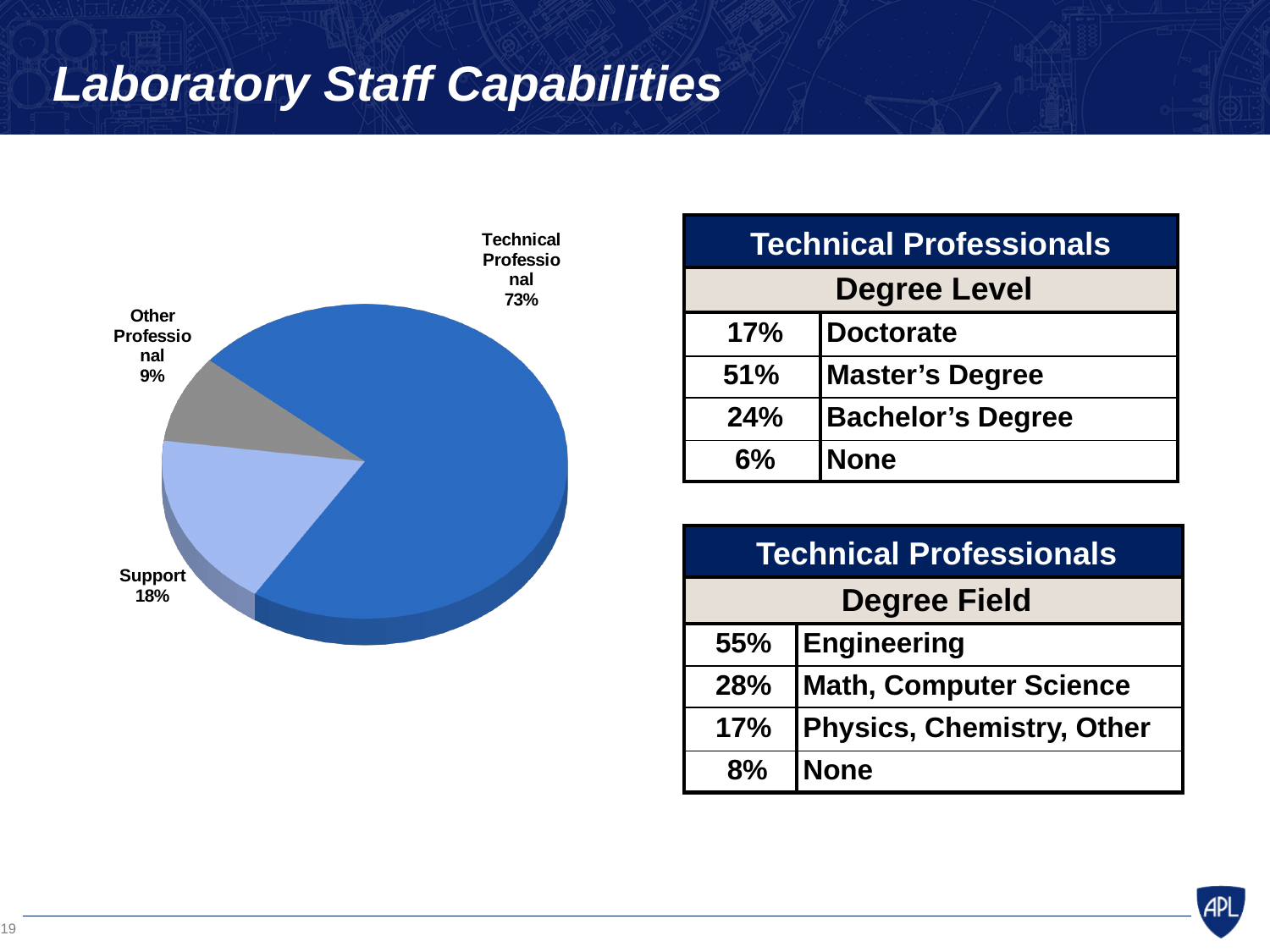
What kind of chart is shown on the slide? pie chart What share of the pie chart is Other Professional? 9% What colour is the Support slice of the pie chart? light blue What share of the pie chart is Support? 18% What share of the pie chart is Technical Professional? 73% What colour is the Other Professional slice of the pie chart? gray How many slices does the pie chart have? 3 What is the difference in percentage points between the Technical Professional and Support slices? 55 Which slice of the pie chart is the smallest? Other Professional Which slice of the pie chart is the largest? Technical Professional Which slice is larger, Support or Other Professional? Support What is the difference in percentage points between the Support and Other Professional slices? 9